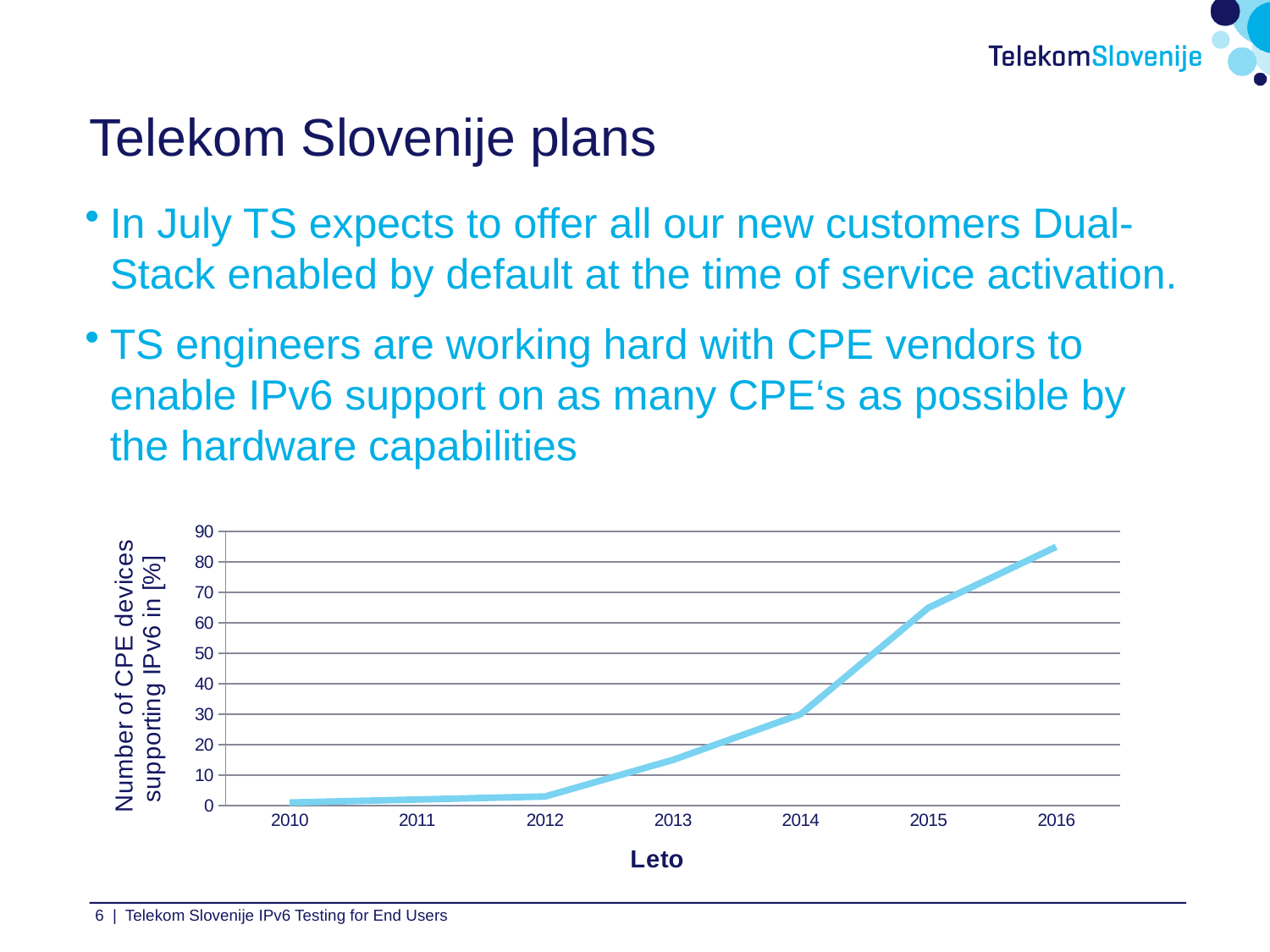
What kind of chart is shown on the slide? line chart How many years are plotted along the x axis of the chart? 7 What is the title of the x axis of the chart? Leto What is the title of the y axis of the chart? Number of CPE devices supporting IPv6 in [%] Is the value for 2013 greater or less than 20? less Do the values rise or fall from 2010 to 2016? rise Which year has the larger value, 2014 or 2015? 2015 Is the value for 2016 greater or less than 80? greater Is the value for 2014 greater or less than 40? less Which year has the highest value in the chart? 2016